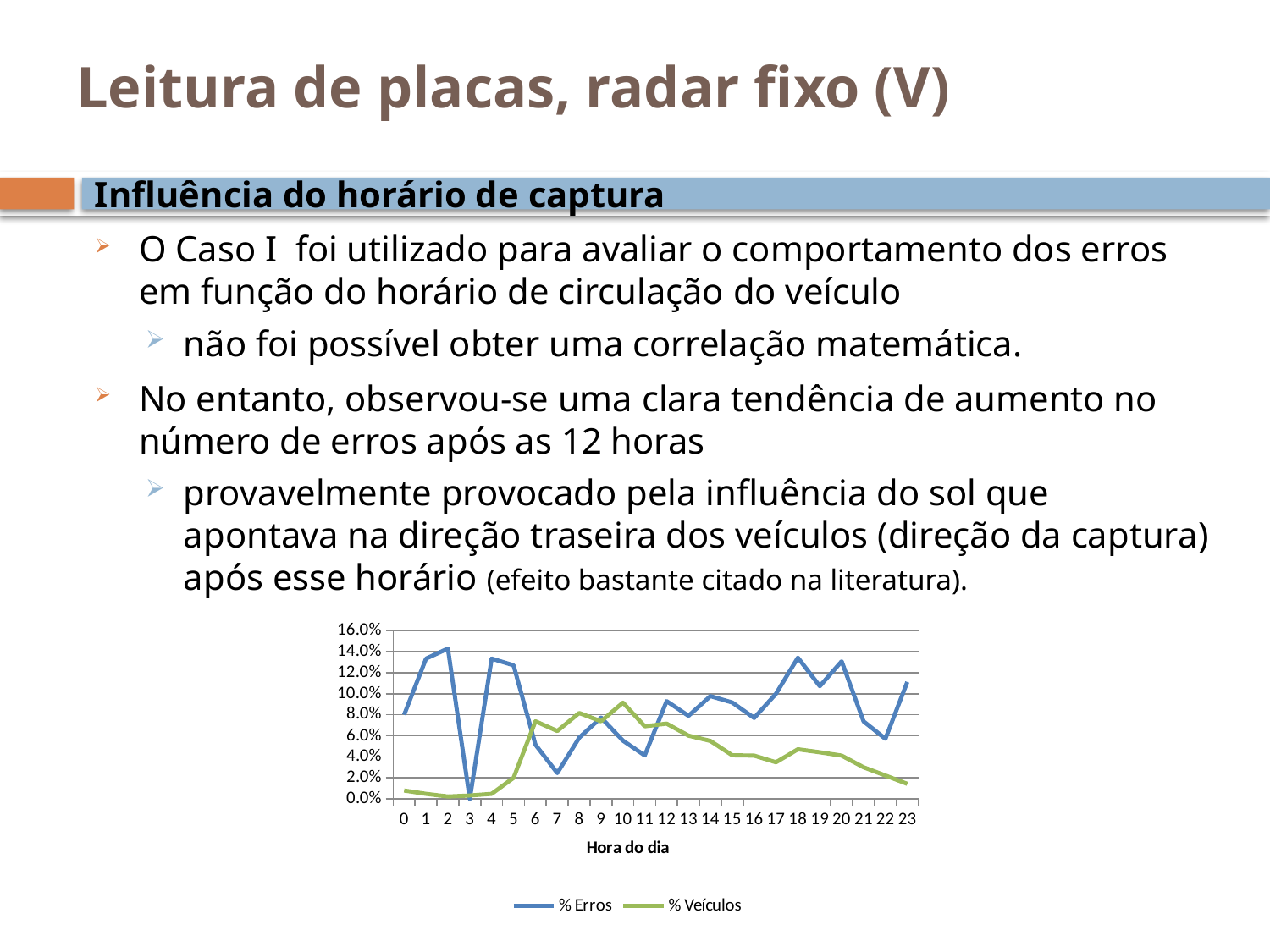
Which two series are listed in the chart legend? % Erros and % Veículos Is the value of % Erros at hour 2 greater or less than 12.0%? greater How many series does the chart legend list? 2 Is the value of % Veículos at hour 23 greater or less than 4.0%? less At hour 10, which series has the higher value, % Erros or % Veículos? % Veículos How many hours (points) are plotted along the x axis of the chart? 24 What is the title of the x axis of the chart? Hora do dia At hour 18, which series has the higher value, % Erros or % Veículos? % Erros At which hour of the day does % Erros reach its lowest value? 3 What kind of chart is shown on the slide? line chart Is the value of % Erros at hour 7 greater or less than 4.0%? less Does the % Veículos series rise or fall from hour 10 to hour 23? fall